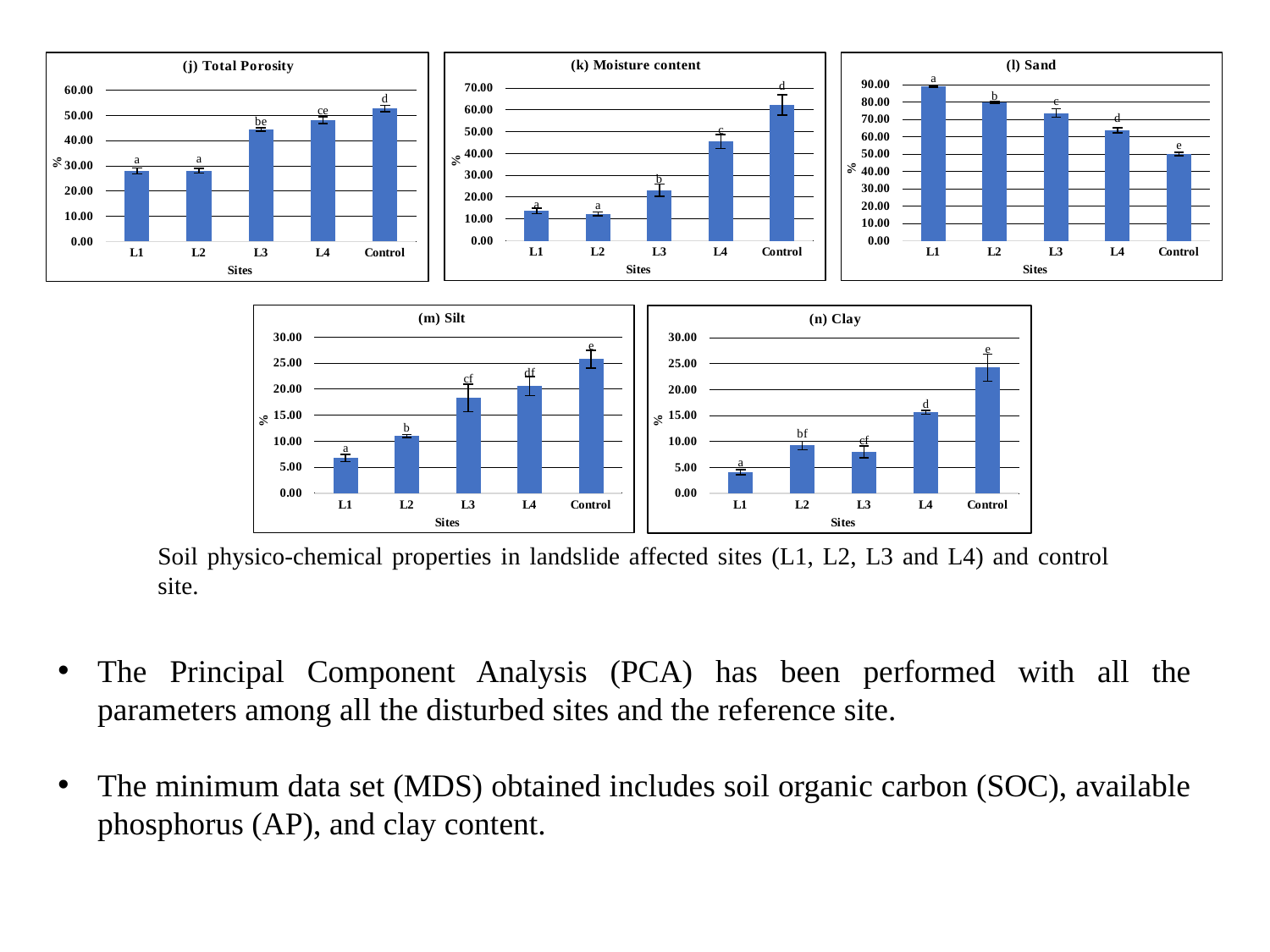
In the (k) Moisture content chart, which site has the highest moisture content? Control In the (n) Clay chart, is the value for Control greater or less than 20.00? greater In the (j) Total Porosity chart, is the value for L3 greater or less than 40.00? greater In the (j) Total Porosity chart, which site has the highest total porosity? Control In the (l) Sand chart, do the values rise or fall from L1 to Control? fall How many sites are plotted on the x axis of the (n) Clay chart? 5 In the (l) Sand chart, which is larger, the value for L2 or the value for L3? L2 What kind of chart is the (m) Silt chart? bar chart In the (l) Sand chart, which site has the lowest sand content? Control In the (m) Silt chart, which site has the lowest silt content? L1 In the (k) Moisture content chart, is the value for L4 greater or less than 40.00? greater